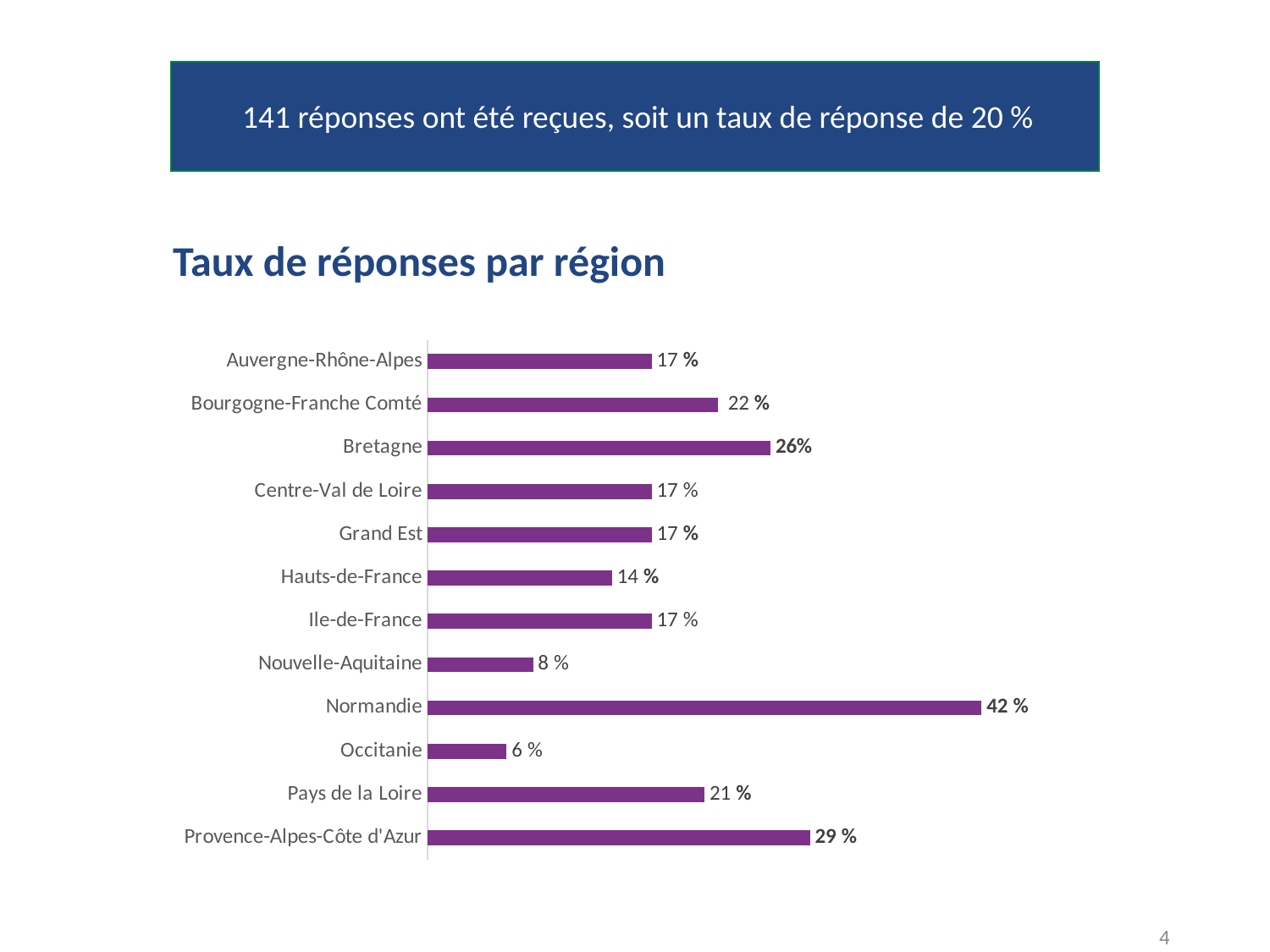
What is the response rate for Bretagne? 26% What is the difference between the response rates of Normandie and Provence-Alpes-Côte d'Azur? 13 % What kind of chart is used to show the response rates by region? Bar chart What is the title of the chart? Taux de réponses par région Which region has the lowest response rate? Occitanie How many regions are shown in the chart? 12 What is the response rate for Pays de la Loire? 21 % What is the difference between the response rates of Bourgogne-Franche Comté and Nouvelle-Aquitaine? 14 % What is the response rate for Normandie? 42 % Which region has the highest response rate? Normandie What is the response rate for Hauts-de-France? 14 % Which has a higher response rate, Bretagne or Pays de la Loire? Bretagne